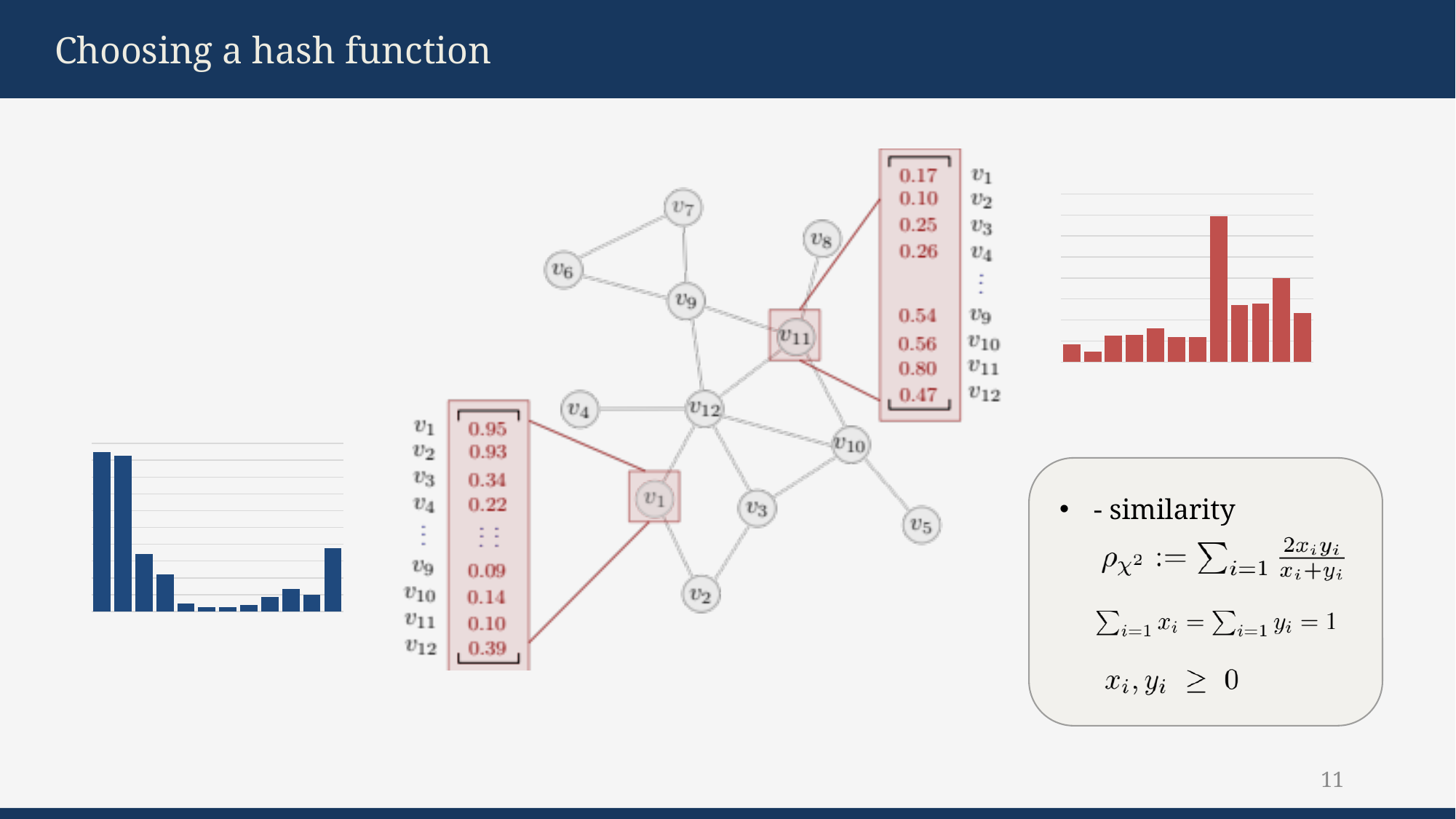
How many bars does the blue chart on the left of the slide have? 12 What colour are the bars in the chart on the left of the slide? blue What kind of chart is the red chart on the right of the slide? bar chart In the red chart on the right of the slide, which is taller: the first bar or the last bar? the last bar In the red chart on the right of the slide, which bar is the tallest? the eighth bar How many bars does the red chart on the right of the slide have? 12 In the blue chart on the left of the slide, do the bar heights generally rise or fall from the first bar to the middle bars? fall In the red chart on the right of the slide, which is taller: the eighth bar or the tenth bar? the eighth bar In the blue chart on the left of the slide, which is taller: the third bar or the fourth bar? the third bar What kind of chart is the blue chart on the left of the slide? bar chart What colour are the bars in the chart on the right of the slide? red